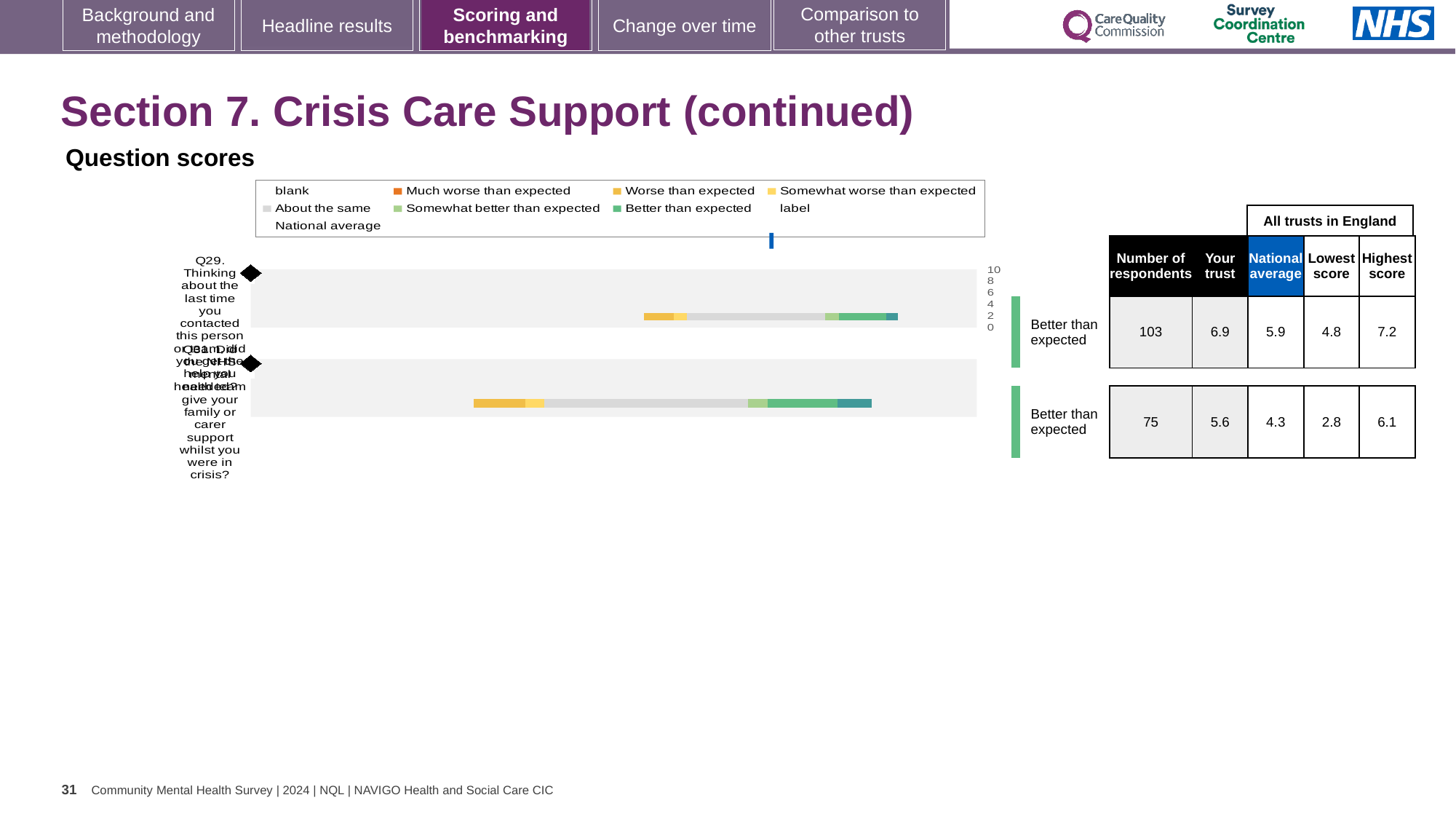
In the table beside the chart, what is the 'Your trust' score for Q29? 6.9 What kind of chart is used to show the question scores on this slide? Bar chart What is the difference between the 'Your trust' score and the national average for Q29? 1.0 In the table beside the chart, what is the national average for Q29? 5.9 In the table beside the chart, how many respondents answered Q31? 75 In the table beside the chart, what is the 'Your trust' score for Q31? 5.6 In the table beside the chart, what is the highest score among all trusts in England for Q31? 6.1 Which question has the higher 'Your trust' score, Q29 or Q31? Q29 Which question has the larger number of respondents? Q29 What benchmark category is shown for Q29 next to the chart? Better than expected How many questions are plotted in the question scores chart? 2 Which question is plotted in the top row of the question scores chart? Q29